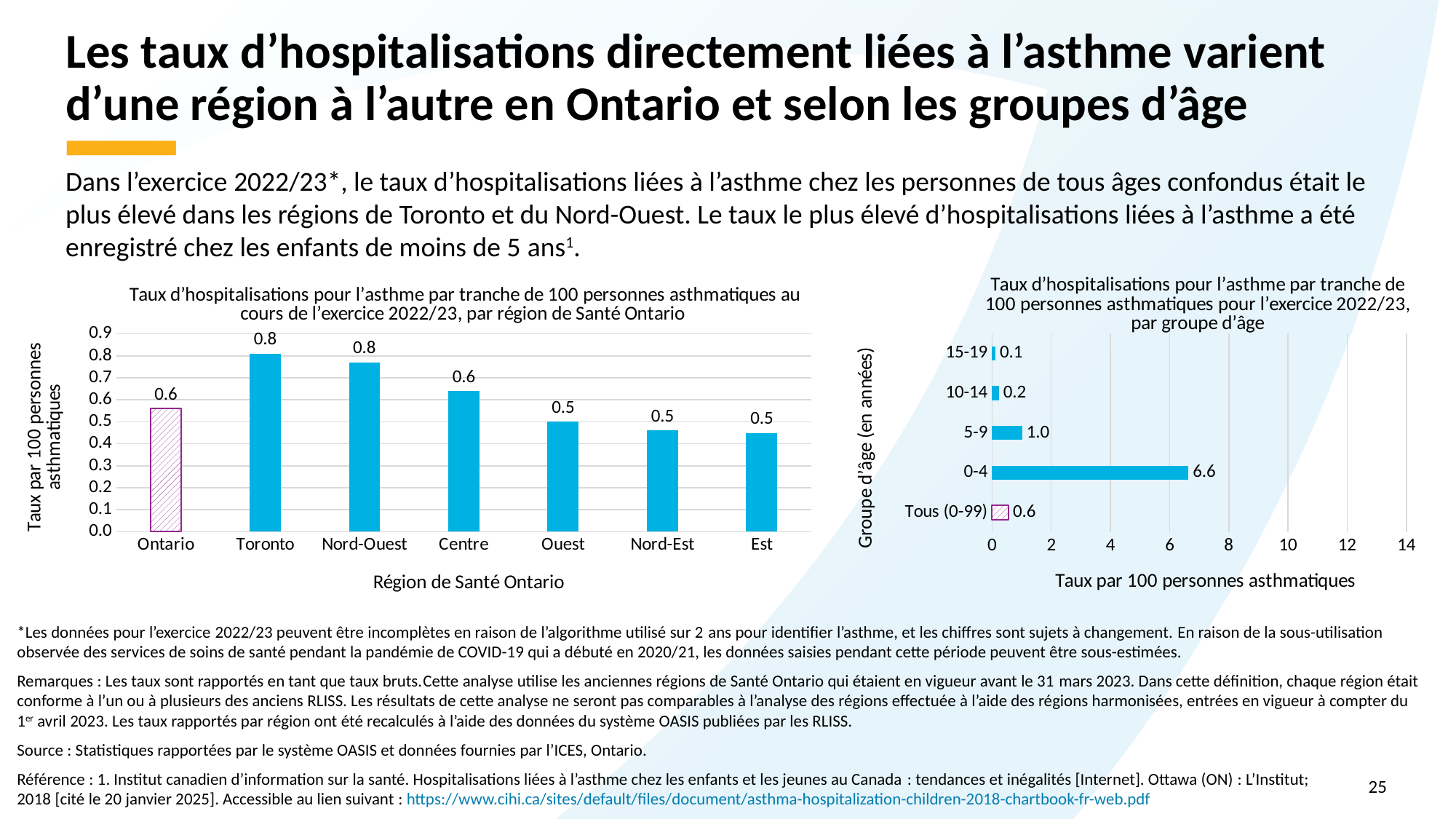
How many age groups are shown in the chart by age group (right)? 5 In the chart by age group (right), what is the hospitalization rate for the 0-4 age group? 6.6 How many regions are shown in the chart by Santé Ontario region (left)? 7 In the chart by Santé Ontario region (left), is the value for Toronto greater or less than 0.7? greater In the chart by Santé Ontario region (left), what is the hospitalization rate for Toronto? 0.8 In the chart by age group (right), which age group has the highest hospitalization rate? 0-4 In the chart by Santé Ontario region (left), which is larger, the value for Toronto or the value for Est? Toronto In the chart by age group (right), which age group has the lowest hospitalization rate? 15-19 In the chart by Santé Ontario region (left), what is the hospitalization rate for Centre? 0.6 What kind of chart is the chart by Santé Ontario region (left)? Bar chart In the chart by age group (right), what is the difference between the values for the 0-4 and 5-9 age groups? 5.6 In the chart by Santé Ontario region (left), what is the difference between the values for Toronto and Centre? 0.2